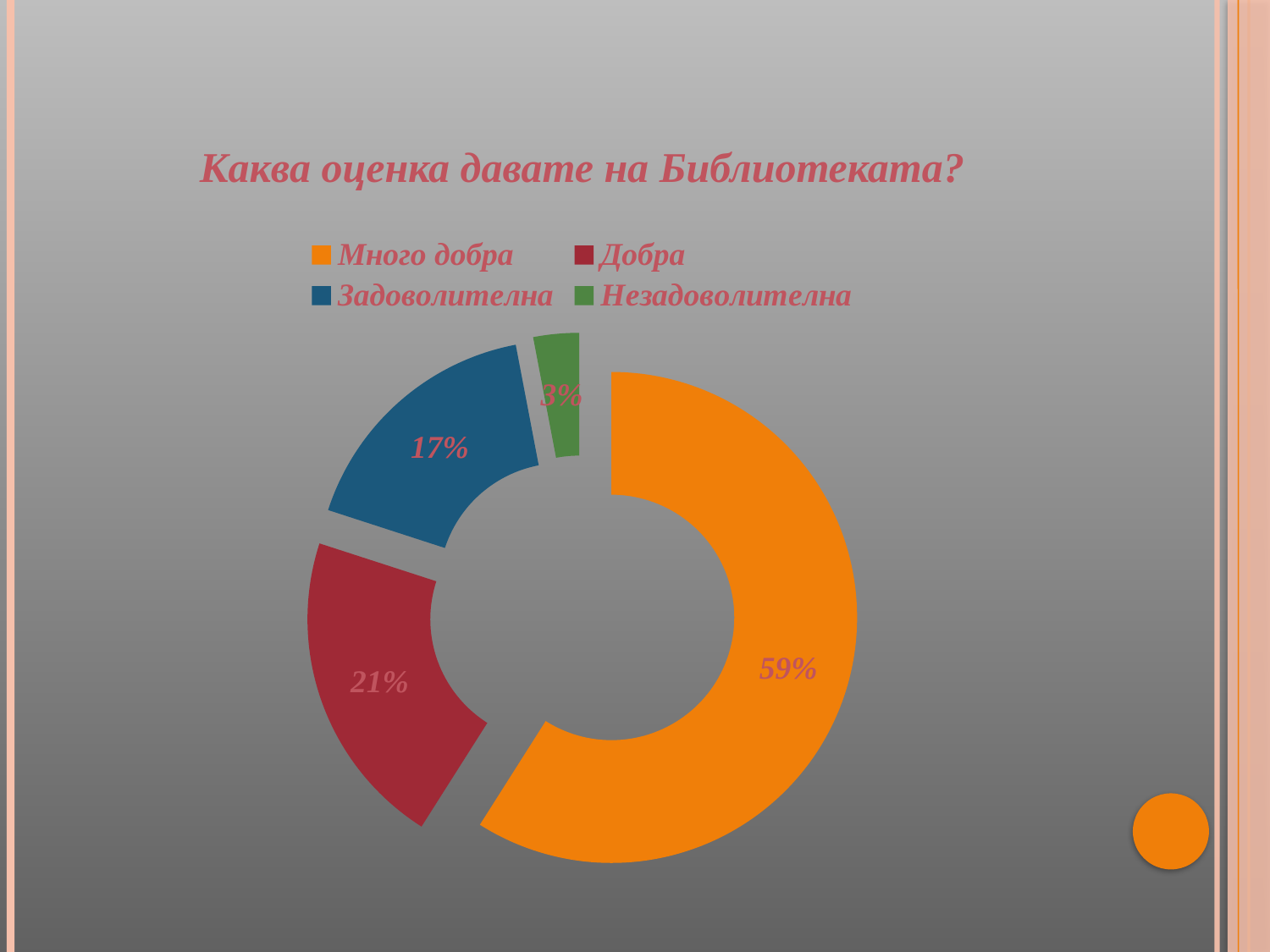
What percentage is shown for Много добра? 59% What is the difference in percentage points between Много добра and Добра? 38 Which category has the largest share? Много добра What percentage is shown for Незадоволителна? 3% Which is larger, the share for Добра or the share for Задоволителна? Добра Which category has the smallest share? Незадоволителна What percentage is shown for Добра? 21% What is the title of the chart? Каква оценка давате на Библиотеката? What kind of chart is shown on the slide? Doughnut (pie) chart What percentage is shown for Задоволителна? 17% What colour is the slice for Задоволителна? Blue How many categories does the chart show? 4